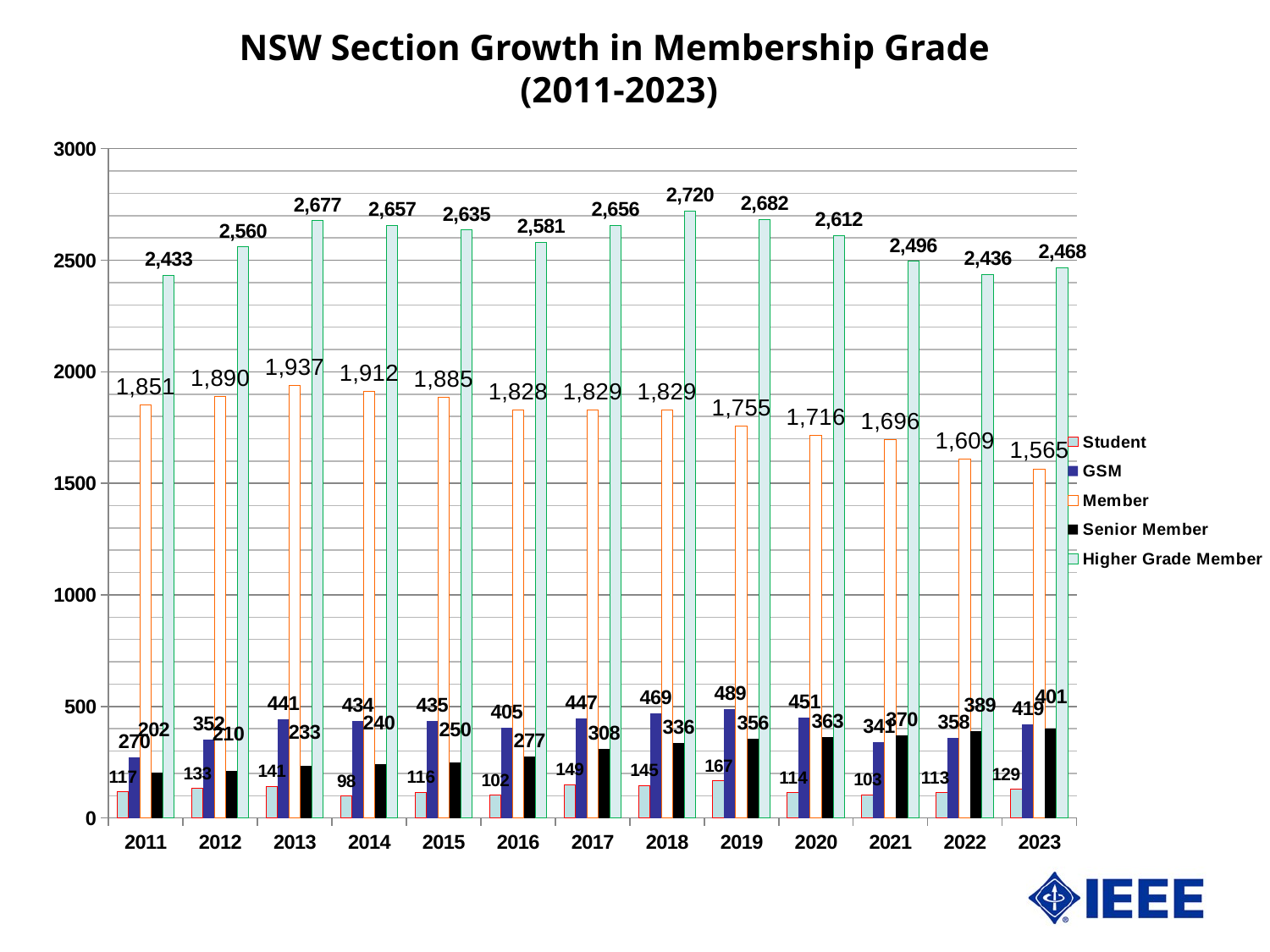
In which year is the Higher Grade Member value highest? 2018 What is the value for GSM in 2011? 270 What is the value for Senior Member in 2023? 401 Do the Senior Member values rise or fall from 2011 to 2023? rise What is the difference between the Member value in 2011 and in 2023? 286 What kind of chart is shown on the slide? bar chart How many years are shown on the x axis? 13 Which year has the larger GSM value, 2019 or 2020? 2019 How many series does the legend list? 5 In which year is the GSM value highest? 2019 What is the value for Member in 2013? 1,937 In which year is the Student value lowest? 2014